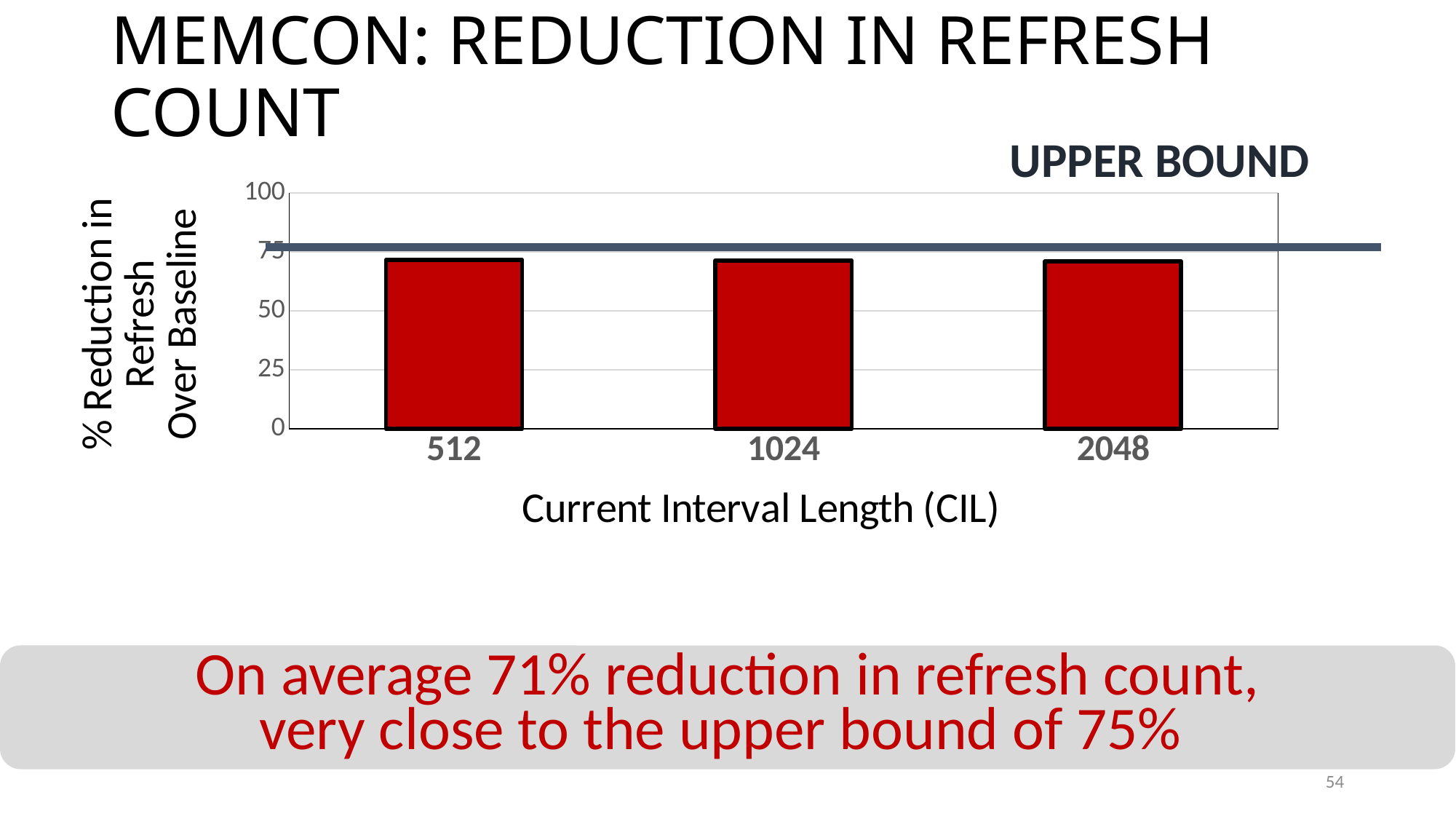
What does the horizontal line drawn across the chart represent, according to its label? UPPER BOUND What is the label of the x axis of the chart? Current Interval Length (CIL) What kind of chart is shown on the slide? bar chart Is the value for CIL 1024 greater or less than 75? less Is the value for CIL 512 greater or less than 50? greater How many Current Interval Length (CIL) categories are plotted in the chart? 3 Is the value for CIL 2048 greater or less than 100? less What are the category labels on the x axis of the chart? 512, 1024, 2048